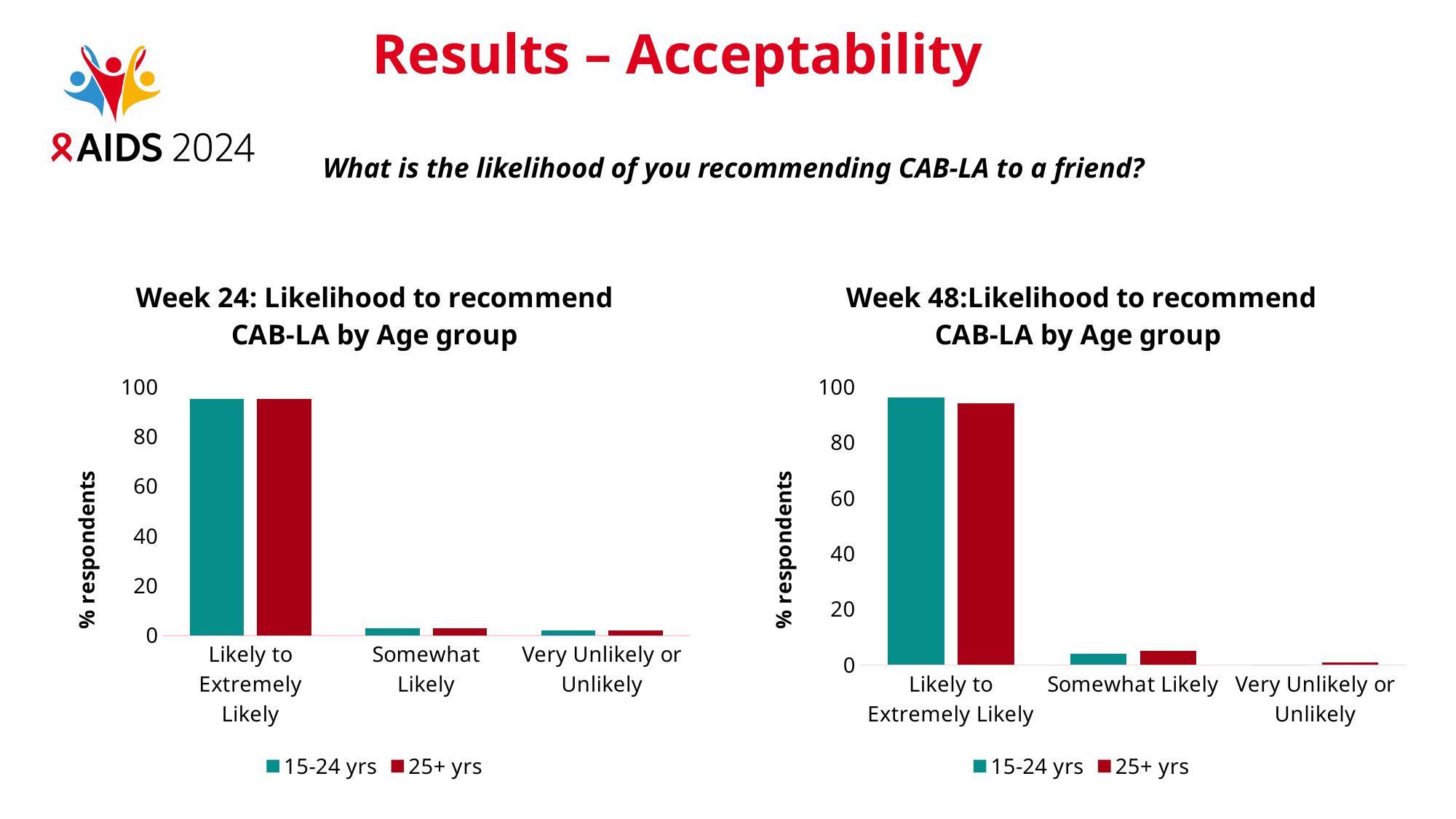
In the Week 48 chart, which category has the lowest value for 25+ yrs? Very Unlikely or Unlikely In the Week 24 chart, is the value for 15-24 yrs in Very Unlikely or Unlikely greater or less than 20? less In the Week 24 chart, is the value for 25+ yrs in Likely to Extremely Likely greater or less than 80? greater What kind of chart is the Week 24 chart on the left? bar chart In the Week 48 chart, is the value for 15-24 yrs in Likely to Extremely Likely greater or less than 80? greater What is the y-axis label of the Week 48 chart? % respondents How many series does the legend of the Week 48 chart list? 2 In the Week 24 chart, which category has the highest value for 15-24 yrs? Likely to Extremely Likely Which series is shown in red in the Week 24 chart? 25+ yrs How many categories are shown on the x axis of the Week 24 chart? 3 In the Week 48 chart, which is larger for 15-24 yrs: Likely to Extremely Likely or Somewhat Likely? Likely to Extremely Likely